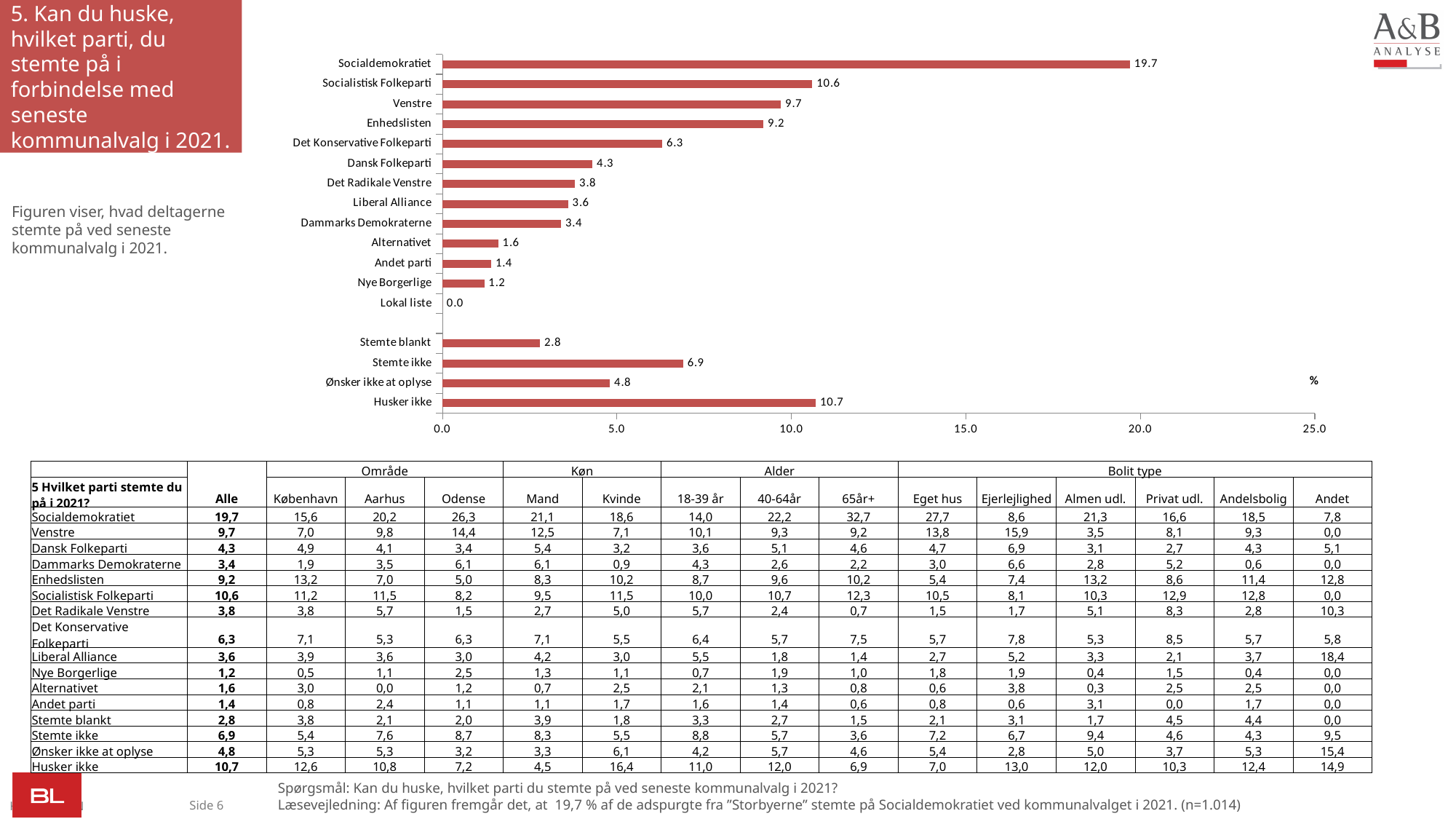
What kind of chart is shown on the slide? bar chart What is the value for Stemte blankt in the bar chart? 2.8 What is the value for Socialdemokratiet in the bar chart? 19.7 Which category has the lowest value in the bar chart? Lokal liste What is the difference between the values for Socialdemokratiet and Husker ikke? 9.0 What is the maximum value shown on the x axis of the bar chart? 25.0 Is the value for Socialistisk Folkeparti greater or less than 10.0? greater What is the value for Husker ikke in the bar chart? 10.7 What is the value for Det Konservative Folkeparti in the bar chart? 6.3 Which category has the highest value in the bar chart? Socialdemokratiet How many categories are shown in the bar chart? 17 Which has a larger value, Venstre or Enhedslisten? Venstre